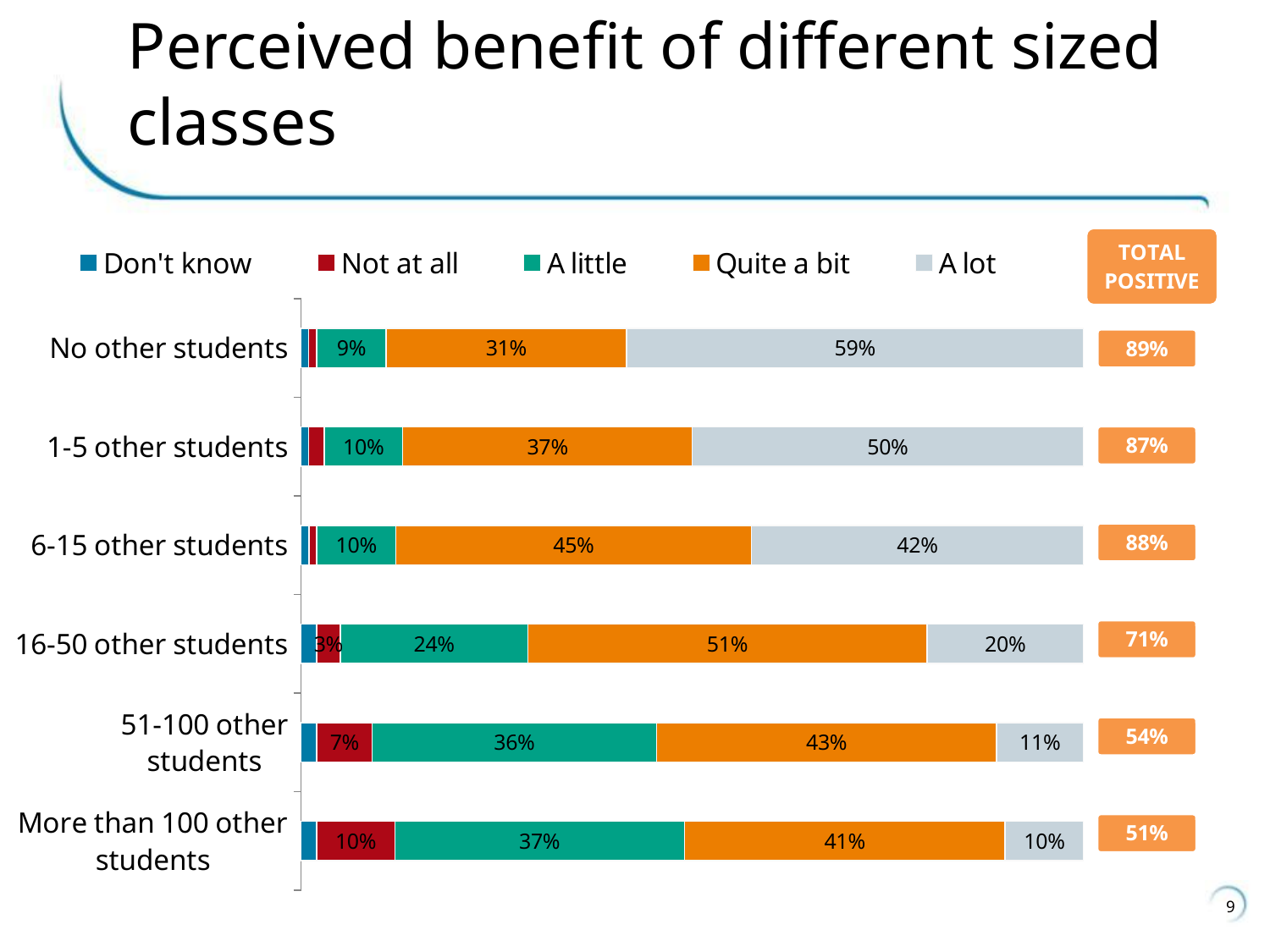
Which class size category has the highest "A lot" value? No other students Which has the larger "A little" value: "16-50 other students" or "51-100 other students"? 51-100 other students What is the "Quite a bit" value for "6-15 other students"? 45% What is the "Not at all" value for "More than 100 other students"? 10% Which class size category has the lowest "A lot" value? More than 100 other students How much larger is the "Quite a bit" value for "16-50 other students" than for "No other students"? 20 percentage points What is the TOTAL POSITIVE value shown for "16-50 other students"? 71% How many series does the legend list? 5 Does the "A lot" value rise or fall as the class size category increases down the chart? fall What percentage of respondents answered "A lot" for "No other students"? 59% What is the "A little" value for "51-100 other students"? 36% How many class size categories are shown in the chart? 6